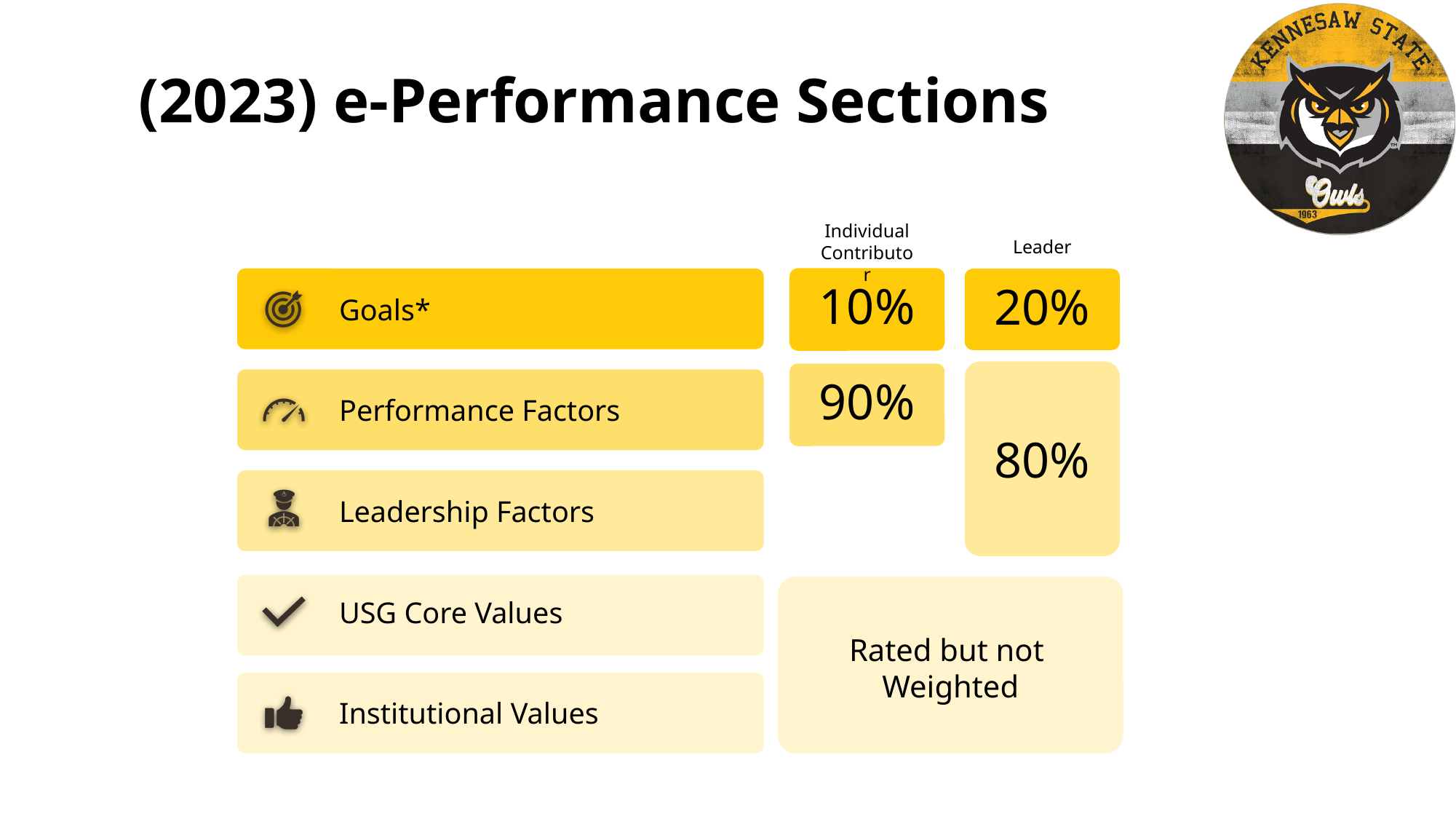
Which section has the highest weight for an Individual Contributor? Performance Factors What is the weight of Goals* for a Leader? 20% What is the weight of Performance Factors for an Individual Contributor? 90% How are USG Core Values and Institutional Values treated according to the slide? Rated but not Weighted What is the total of the Individual Contributor weights for Goals* and Performance Factors? 100% What is the title of the slide? (2023) e-Performance Sections What is the difference between the Leader and Individual Contributor weights for Goals*? 10% What combined weight is shown for Performance Factors and Leadership Factors for a Leader? 80% How many role columns (weighting groups) are shown? 2 How many e-Performance sections are listed on the slide? 5 What is the weight of Goals* for an Individual Contributor? 10% Which has the larger Goals* weight, Individual Contributor or Leader? Leader